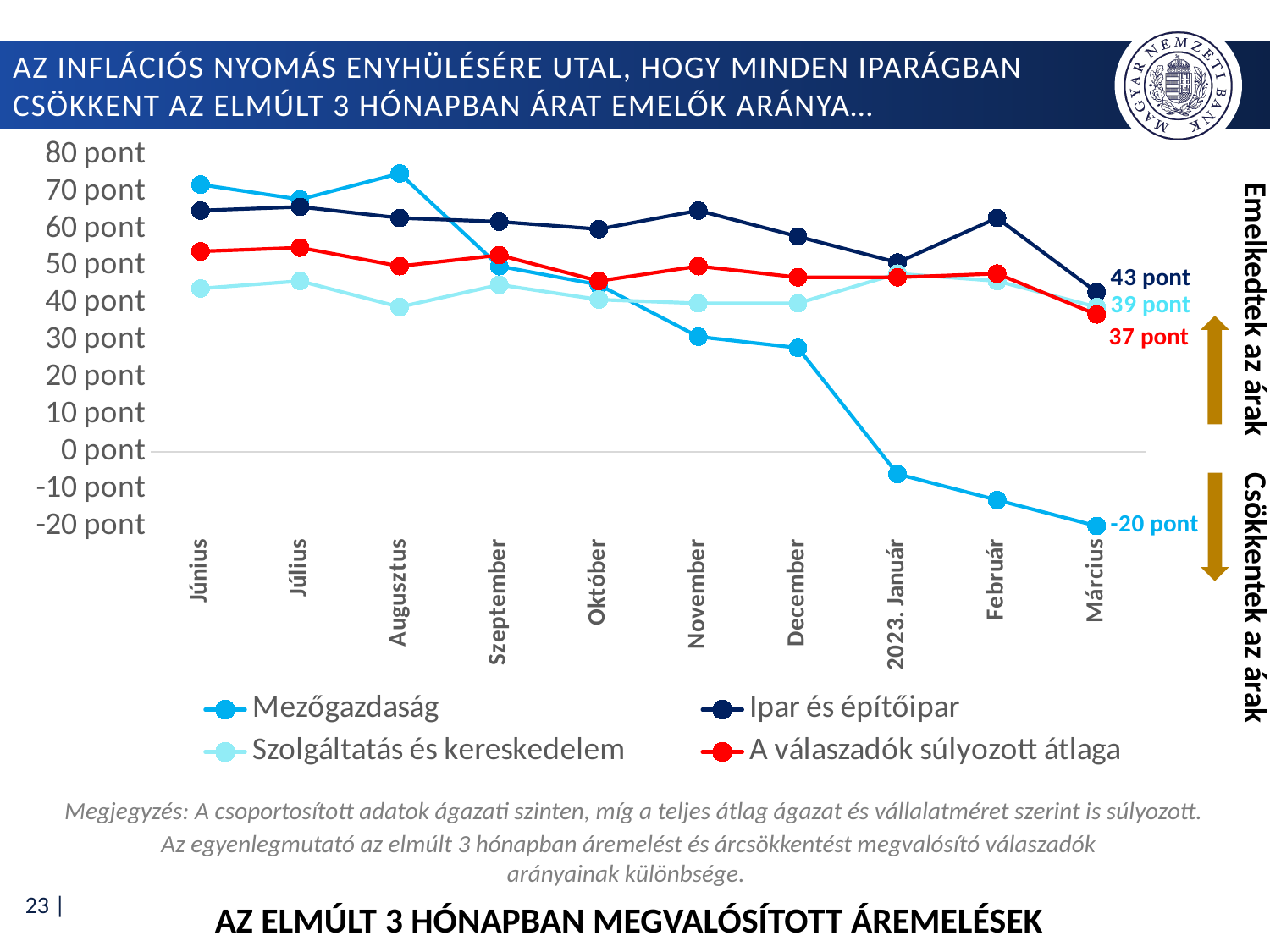
What is the value for Ipar és építőipar in Március? 43 pont What is the difference between Ipar és építőipar and A válaszadók súlyozott átlaga in Március? 6 pont What is the value for Mezőgazdaság in Március? -20 pont How many months are shown on the x axis? 10 What is the value for Szolgáltatás és kereskedelem in Március? 39 pont What is the value for A válaszadók súlyozott átlaga in Március? 37 pont Is the value for Mezőgazdaság in Augusztus greater or less than 70 pont? greater Is the value for Mezőgazdaság in December greater or less than 40 pont? less Which series has the lowest value in Március? Mezőgazdaság Which series has the highest value in Március? Ipar és építőipar How many series does the legend list? 4 Does the Mezőgazdaság series rise or fall from Augusztus to Március? fall